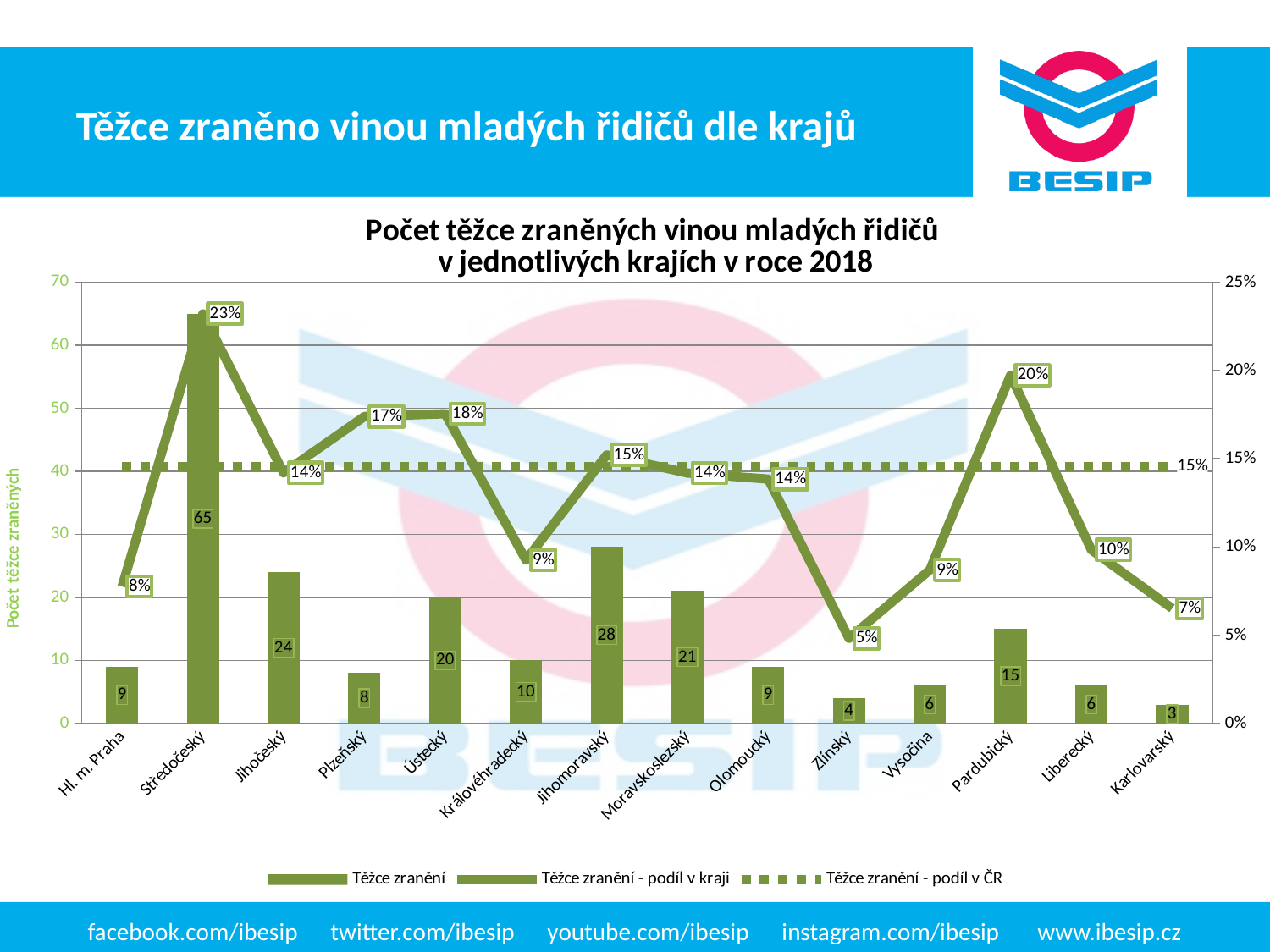
How many regions are shown on the x axis? 14 What is the Těžce zranění - podíl v kraji value for Hl. m. Praha? 8% Which is larger, the Těžce zranění value for Jihočeský or for Ústecký? Jihočeský What is the difference between the Těžce zranění values for Jihomoravský and Moravskoslezský? 7 What is the Těžce zranění - podíl v kraji value for Pardubický? 20% What is the title of the chart? Počet těžce zraněných vinou mladých řidičů v jednotlivých krajích v roce 2018 What is the value of the Těžce zranění - podíl v ČR series? 15% Which region has the highest Těžce zranění value? Středočeský What is the value of Těžce zranění for Středočeský? 65 Which region has the lowest Těžce zranění - podíl v kraji value? Zlínský Which region has the lowest Těžce zranění value? Karlovarský How many series does the legend list? 3